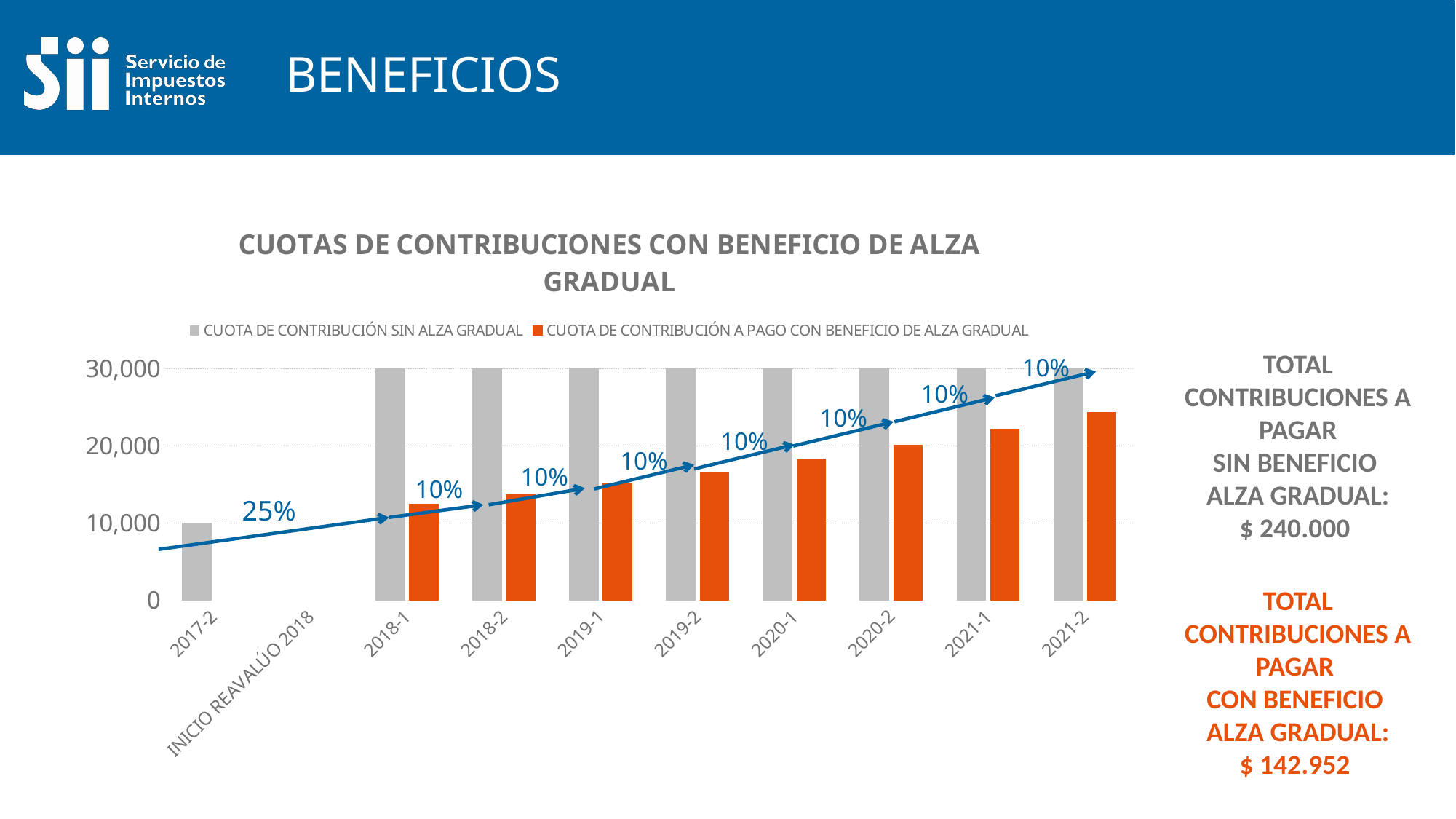
What is the value of CUOTA DE CONTRIBUCIÓN SIN ALZA GRADUAL for 2017-2? 10,000 What kind of chart is shown on the slide? bar chart What is the value of CUOTA DE CONTRIBUCIÓN SIN ALZA GRADUAL for 2021-2? 30,000 What is the difference between the CUOTA DE CONTRIBUCIÓN SIN ALZA GRADUAL values for 2018-1 and 2017-2? 20,000 What percentage label is shown on the line between 2017-2 and 2018-1? 25% Is the value of CUOTA DE CONTRIBUCIÓN A PAGO CON BENEFICIO DE ALZA GRADUAL for 2021-2 greater or less than 20,000? greater Do the values of CUOTA DE CONTRIBUCIÓN A PAGO CON BENEFICIO DE ALZA GRADUAL rise or fall from 2018-1 to 2021-2? rise How many series does the legend list? 2 Is the value of CUOTA DE CONTRIBUCIÓN A PAGO CON BENEFICIO DE ALZA GRADUAL for 2019-2 greater or less than 20,000? less How many categories are shown on the x axis? 10 Which category has the highest value for CUOTA DE CONTRIBUCIÓN A PAGO CON BENEFICIO DE ALZA GRADUAL? 2021-2 Which category has the lowest value for CUOTA DE CONTRIBUCIÓN A PAGO CON BENEFICIO DE ALZA GRADUAL? 2018-1